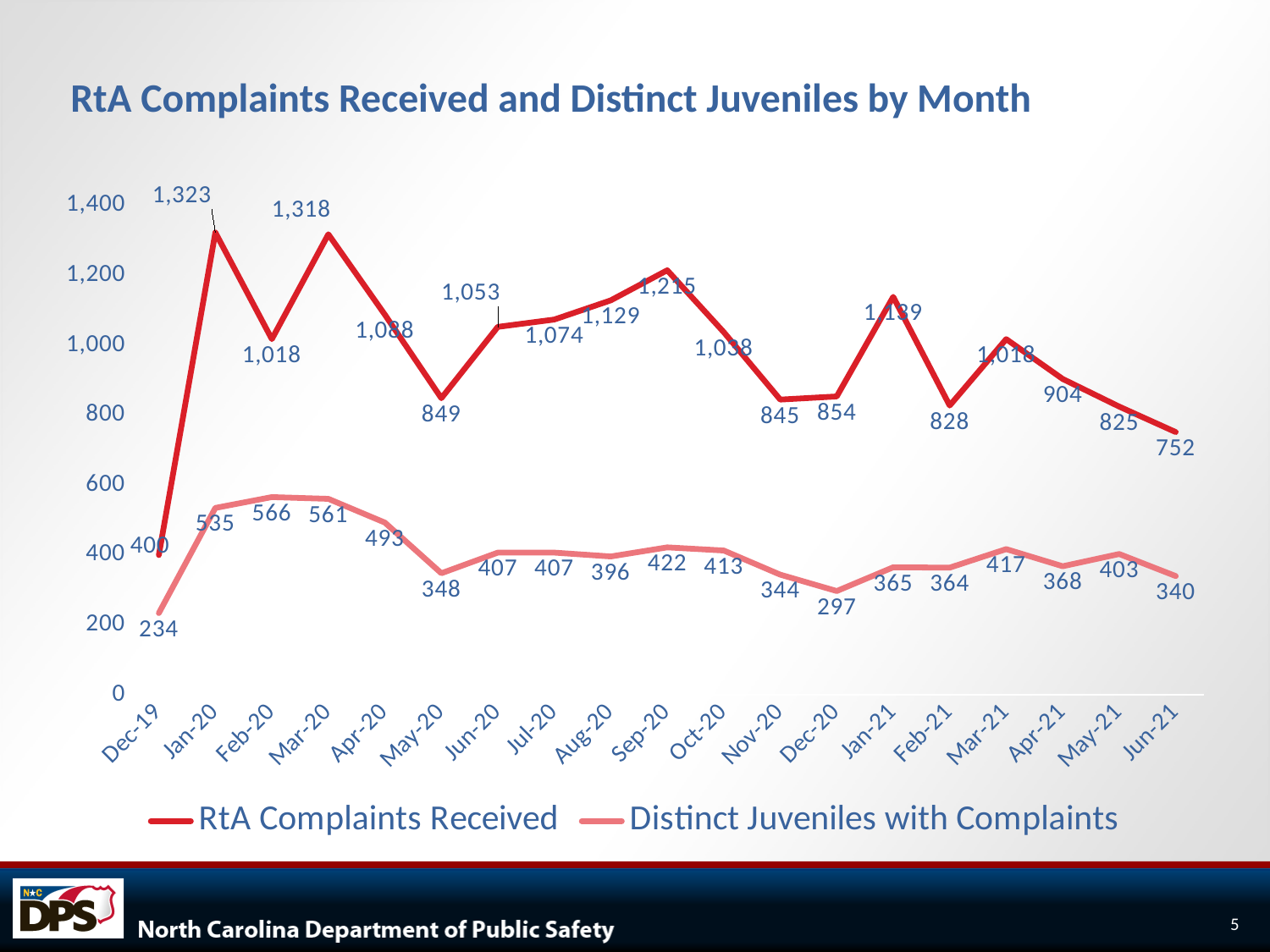
Which month has the lowest value for Distinct Juveniles with Complaints? Dec-19 Do the values for RtA Complaints Received rise or fall from Mar-21 to Jun-21? Fall What is the value for Distinct Juveniles with Complaints in Dec-20? 297 In Jun-21, what is the difference between RtA Complaints Received and Distinct Juveniles with Complaints? 412 How many series does the legend list? 2 Which month has the highest value for RtA Complaints Received? Jan-20 What is the difference between RtA Complaints Received in Jan-20 and Feb-20? 305 What kind of chart is shown on the slide? Line chart How many months are shown on the x axis? 19 Which month has the highest value for Distinct Juveniles with Complaints? Feb-20 What is the value for RtA Complaints Received in Jan-20? 1,323 Which month has the larger value for RtA Complaints Received, Nov-20 or Dec-20? Dec-20